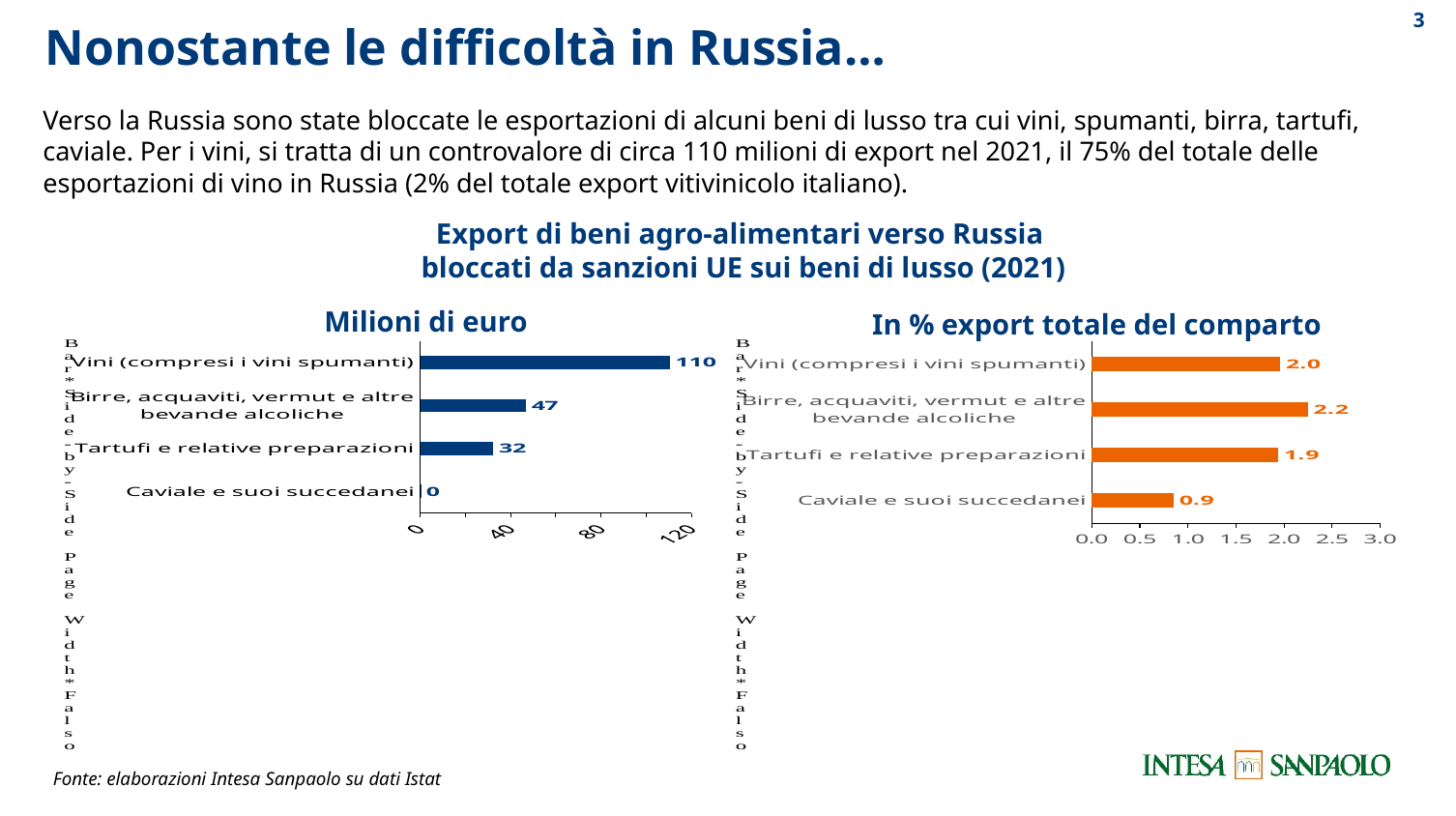
In the 'Milioni di euro' chart, which category has the highest value? Vini (compresi i vini spumanti) How many categories are shown in the 'Milioni di euro' chart? 4 In the 'Milioni di euro' chart, what is the value for Tartufi e relative preparazioni? 32 In the 'In % export totale del comparto' chart, what is the value for Birre, acquaviti, vermut e altre bevande alcoliche? 2.2 In the 'Milioni di euro' chart, which category has the lowest value? Caviale e suoi succedanei What type of chart is the 'In % export totale del comparto' chart? Bar chart In the 'In % export totale del comparto' chart, what is the value for Caviale e suoi succedanei? 0.9 In the 'In % export totale del comparto' chart, which category has the highest value? Birre, acquaviti, vermut e altre bevande alcoliche In the 'Milioni di euro' chart, what is the value for Vini (compresi i vini spumanti)? 110 In the 'In % export totale del comparto' chart, which is larger: the value for Vini (compresi i vini spumanti) or the value for Caviale e suoi succedanei? Vini (compresi i vini spumanti) In the 'Milioni di euro' chart, what is the difference between the values for Vini (compresi i vini spumanti) and Birre, acquaviti, vermut e altre bevande alcoliche? 63 In the 'In % export totale del comparto' chart, which category has the lowest value? Caviale e suoi succedanei